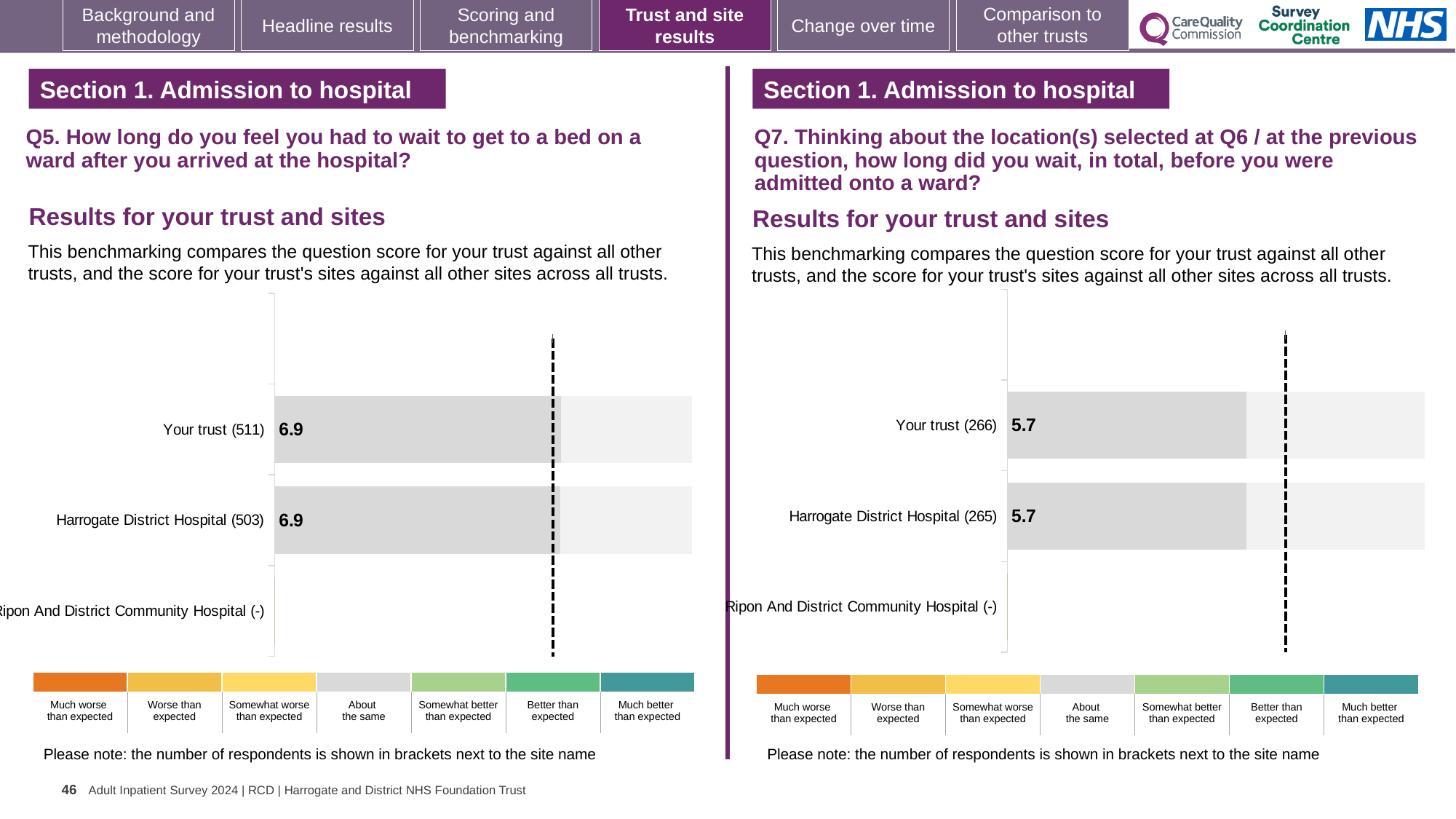
How many site/trust categories are listed on the left chart (Q5)? 3 On the left chart (Q5), how many respondents are shown in brackets for Your trust? 511 On the left chart (Q5), what is the difference between the score for Your trust and the score for Harrogate District Hospital? 0 On the right chart (Q7), what is the score for Harrogate District Hospital (265)? 5.7 On the left chart (Q5), what is the score for Harrogate District Hospital (503)? 6.9 On the right chart (Q7), which category has no score shown (marked with a dash)? Ripon And District Community Hospital On the right chart (Q7), what is the score for Your trust (266)? 5.7 On the left chart (Q5), what is the score for Your trust (511)? 6.9 On the right chart (Q7), what is the difference between the score for Your trust and the score for Harrogate District Hospital? 0 On the right chart (Q7), how many respondents are shown in brackets for Harrogate District Hospital? 265 How many site/trust categories are listed on the right chart (Q7)? 3 What kind of chart is used on the left (Q5) to show the results? Bar chart